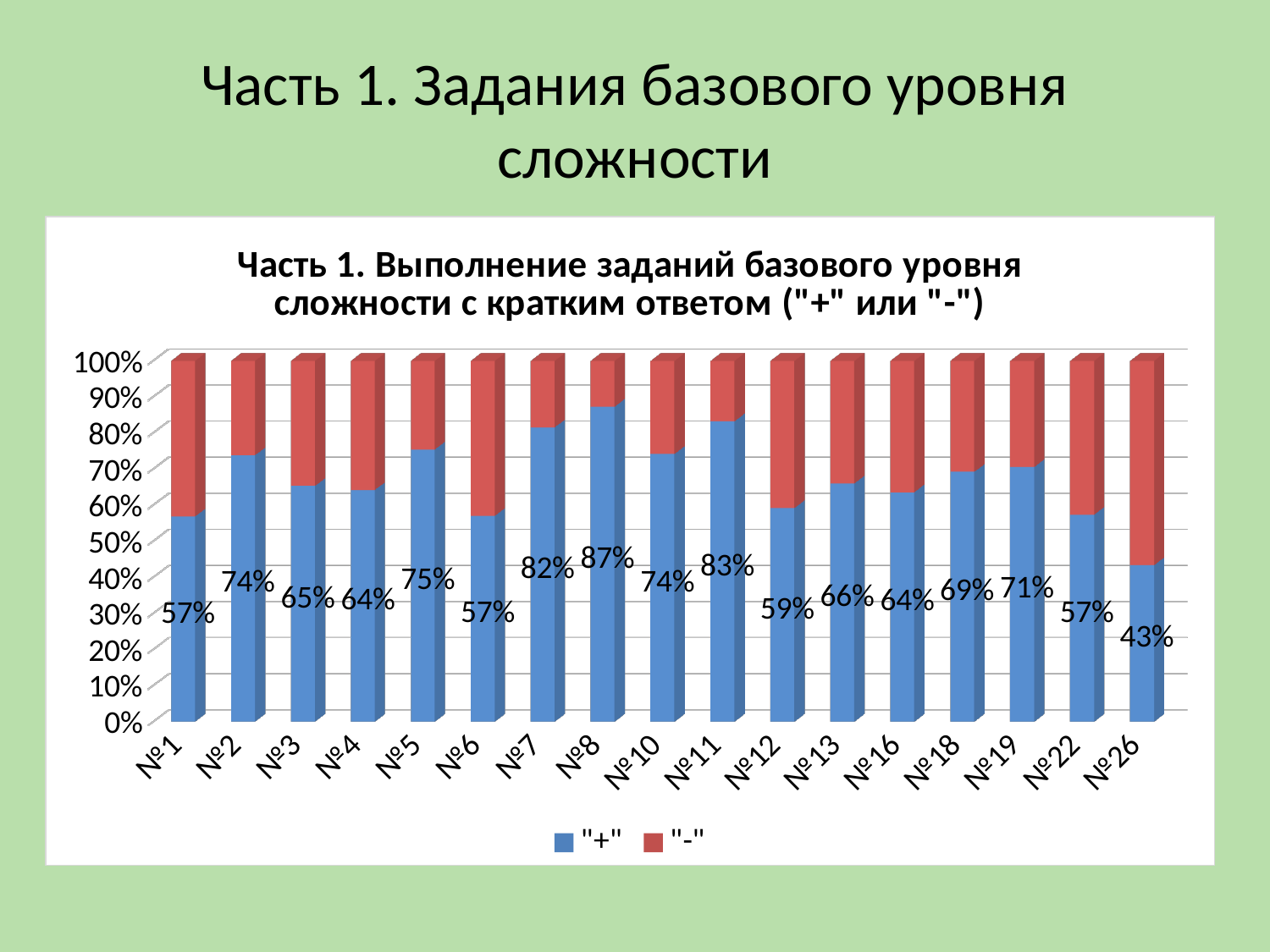
What kind of chart is this? Stacked bar chart What is the "+" value for №12? 59% How many tasks are shown on the x axis? 17 What is the "+" value for №19? 71% What is the difference between the "+" values for №8 and №26? 44% How many series does the legend list? 2 Which colour represents the "-" series? Red What is the "+" value for №8? 87% Which task has the lowest "+" value? №26 Which has a larger "+" value, №5 or №13? №5 Which task has the highest "+" value? №8 Is the "+" value for №7 greater or less than 70%? greater